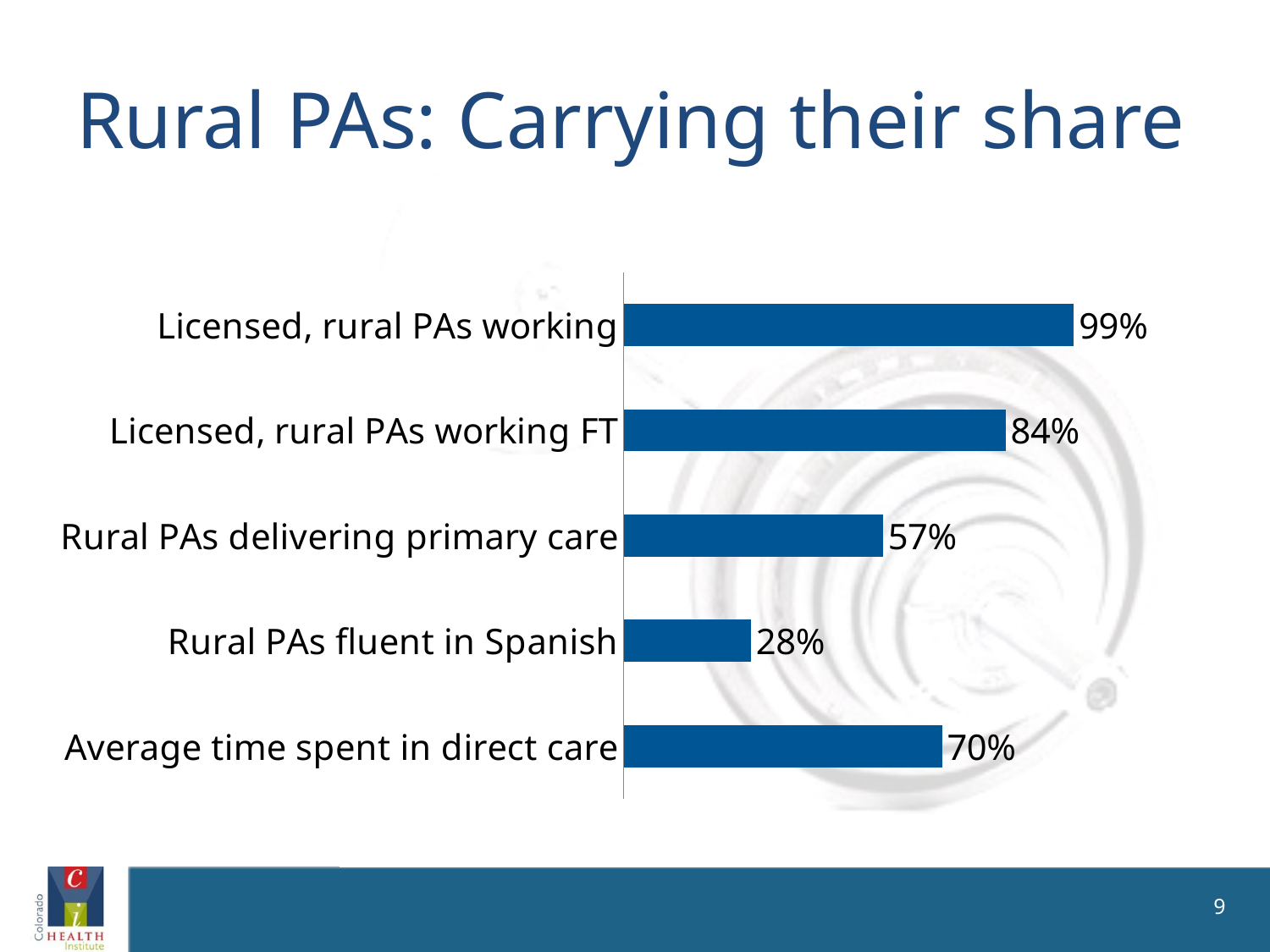
What is the value for Rural PAs fluent in Spanish? 28% What is the difference between Average time spent in direct care and Rural PAs delivering primary care? 13% What is the difference between Licensed, rural PAs working and Licensed, rural PAs working FT? 15% Which is larger: Rural PAs delivering primary care or Average time spent in direct care? Average time spent in direct care Which category has the highest value? Licensed, rural PAs working How many categories are shown in the chart? 5 Which category has the lowest value? Rural PAs fluent in Spanish What colour are the bars in the chart? Blue What is the value for Average time spent in direct care? 70% What is the title of the slide? Rural PAs: Carrying their share What kind of chart is shown on the slide? Bar chart What is the value for Licensed, rural PAs working? 99%